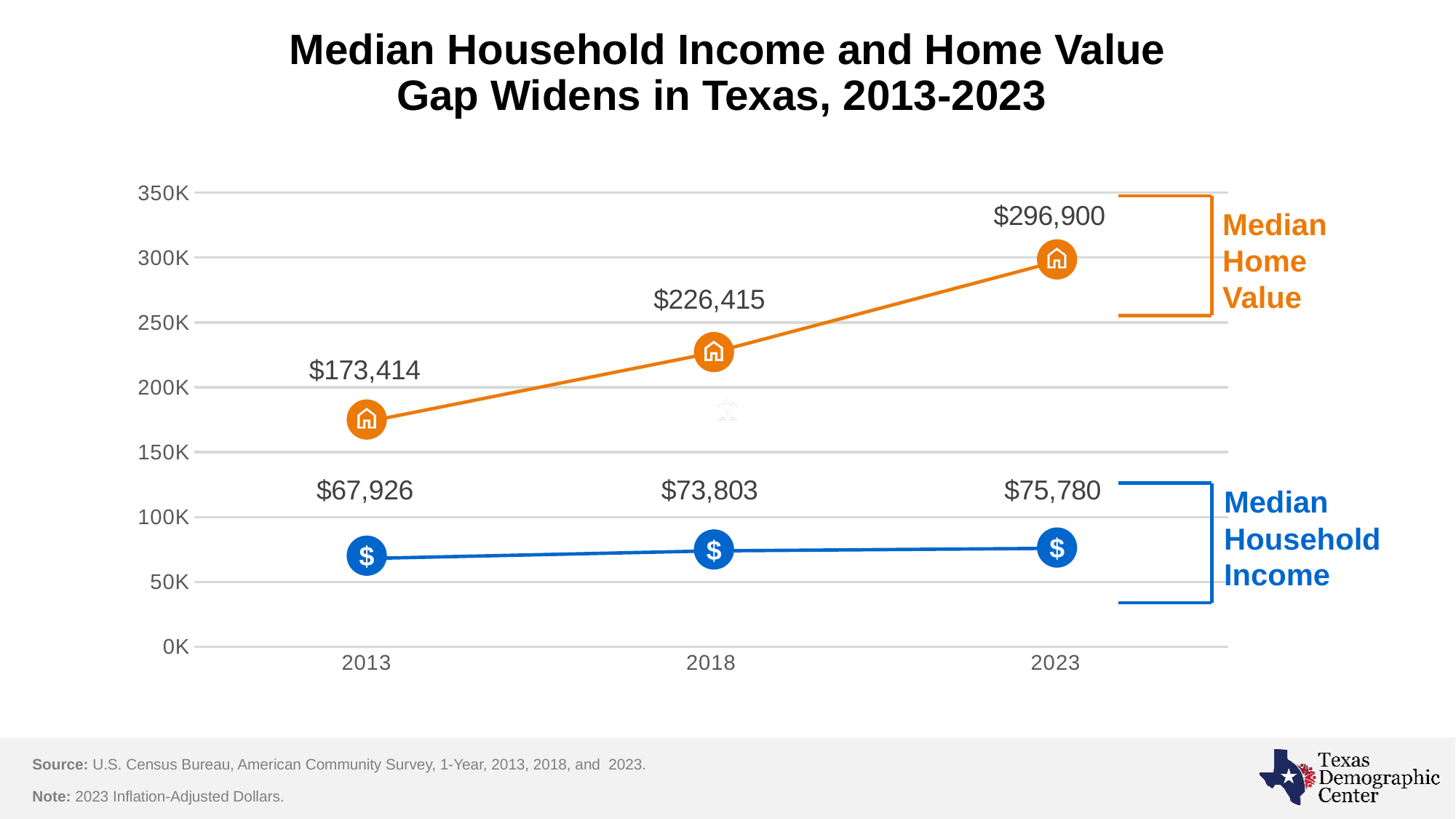
What was the median home value in 2018? $226,415 What type of chart is shown on the slide? Line chart What was the median household income in Texas in 2013? $67,926 By how much did the median home value increase from 2013 to 2023? $123,486 In which year was the median household income lowest? 2013 What is the difference between the median home value and the median household income in 2023? $221,120 What was the median household income in 2018? $73,803 What was the median home value in Texas in 2023? $296,900 Which was larger in 2013: the median home value or the median household income? Median home value In which year was the median home value highest? 2023 Does the median household income rise or fall from 2013 to 2023? Rise How many years are plotted on the x axis? 3